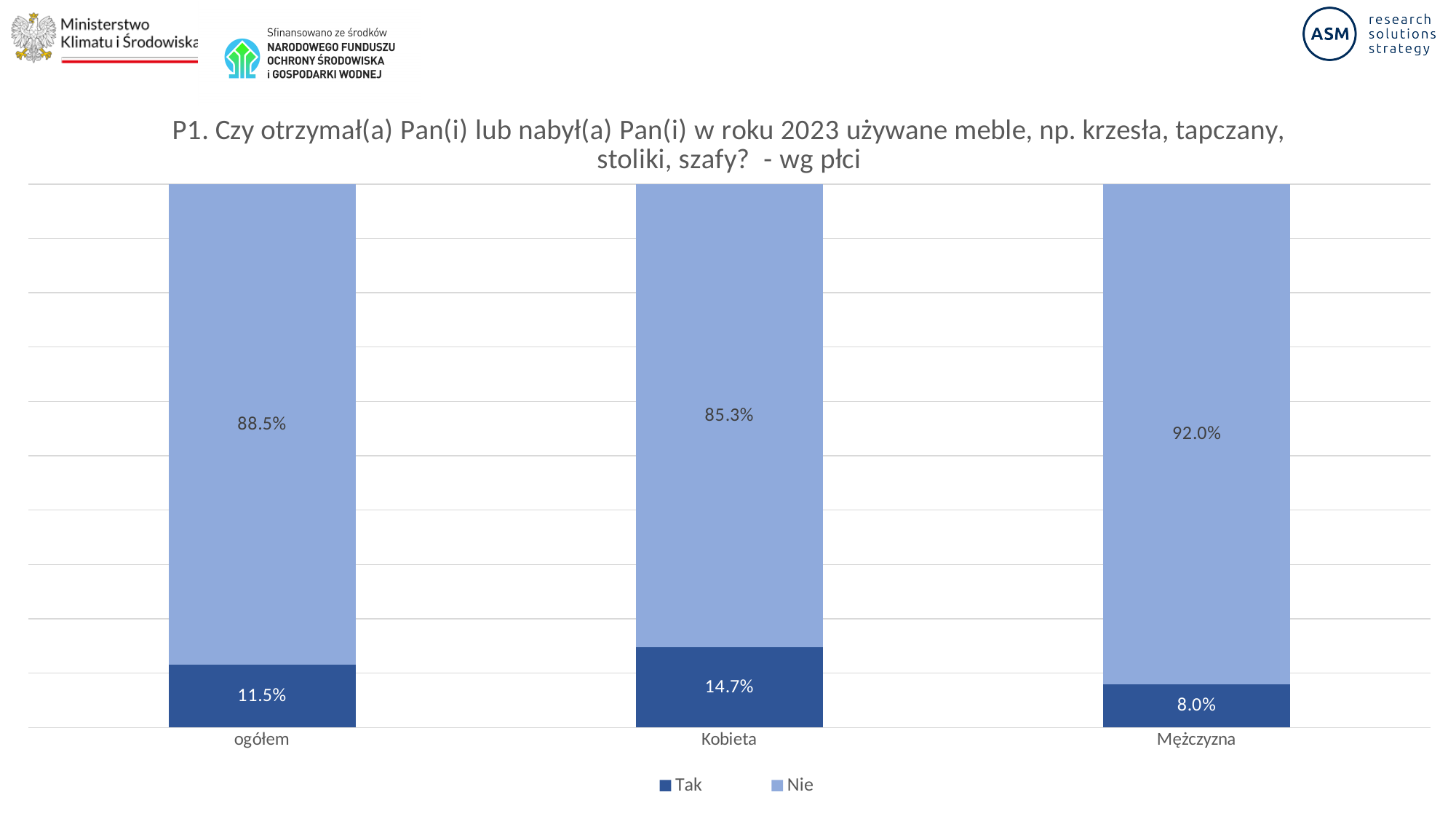
What kind of chart is shown on the slide? Stacked bar chart Which category has the highest 'Tak' value? Kobieta What is the 'Nie' value for Mężczyzna? 92.0% How many categories are shown on the x axis? 3 What is the 'Tak' value for ogółem? 11.5% What is the difference between the 'Tak' values for Kobieta and Mężczyzna? 6.7 percentage points What is the 'Tak' value for Kobieta? 14.7% What are the two legend entries of the chart? Tak and Nie Which is larger: the 'Nie' value for Kobieta or for Mężczyzna? Mężczyzna Which category has the lowest 'Tak' value? Mężczyzna How many series does the legend list? 2 What is the 'Nie' value for Kobieta? 85.3%